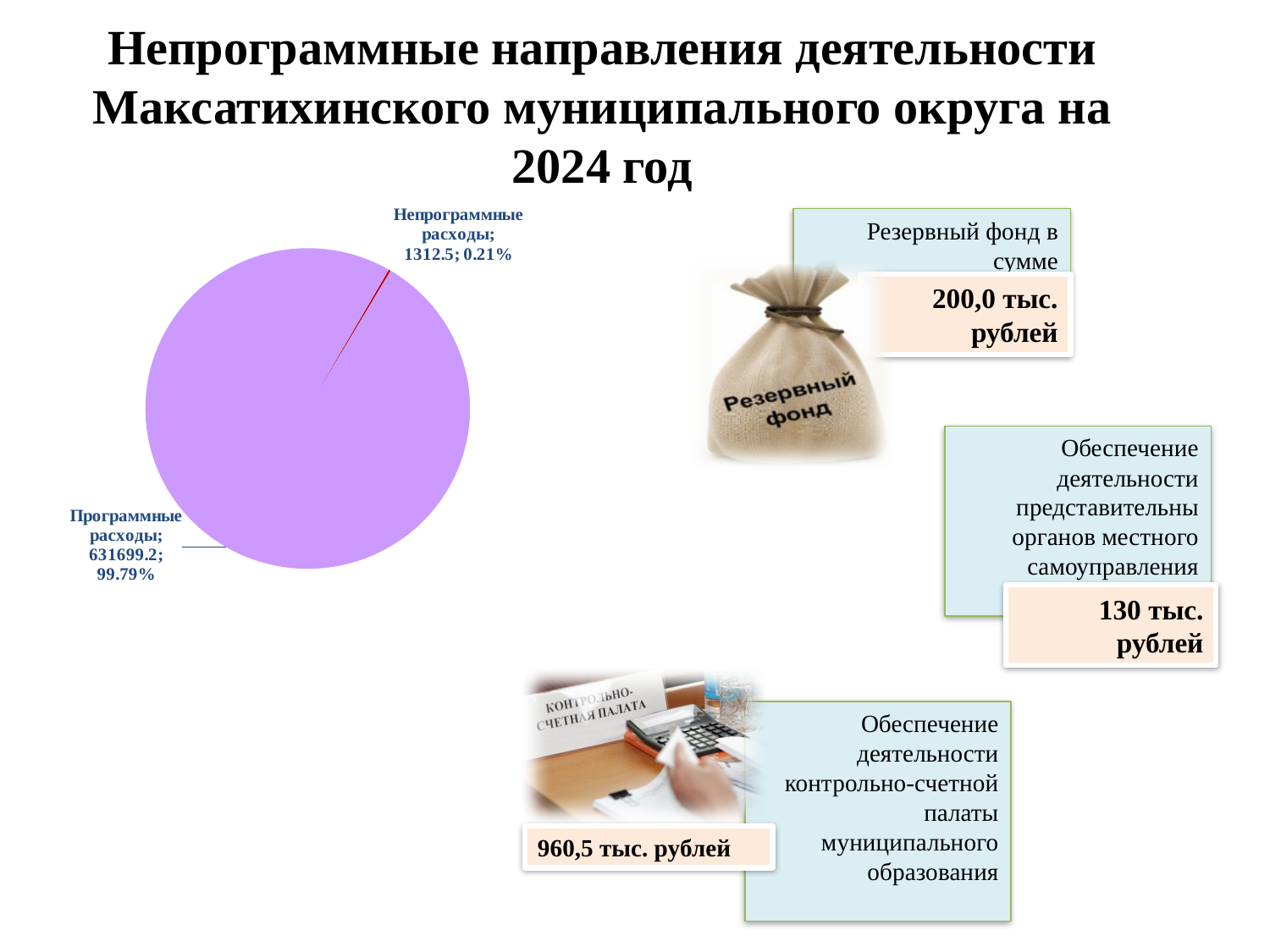
What is the value shown for Программные расходы in the pie chart? 631699.2 What is the total of the two values shown in the pie chart? 633011.7 How many slices does the pie chart have? 2 Which is larger in the pie chart: Программные расходы or Непрограммные расходы? Программные расходы What share of the pie does Непрограммные расходы represent? 0.21% What colour is the Программные расходы slice in the pie chart? purple Which slice of the pie chart is the smallest? Непрограммные расходы Which slice of the pie chart is the largest? Программные расходы What is the value shown for Непрограммные расходы in the pie chart? 1312.5 What kind of chart is shown on the slide? pie chart What is the difference between the values for Программные расходы and Непрограммные расходы in the pie chart? 630386.7 What share of the pie does Программные расходы represent? 99.79%